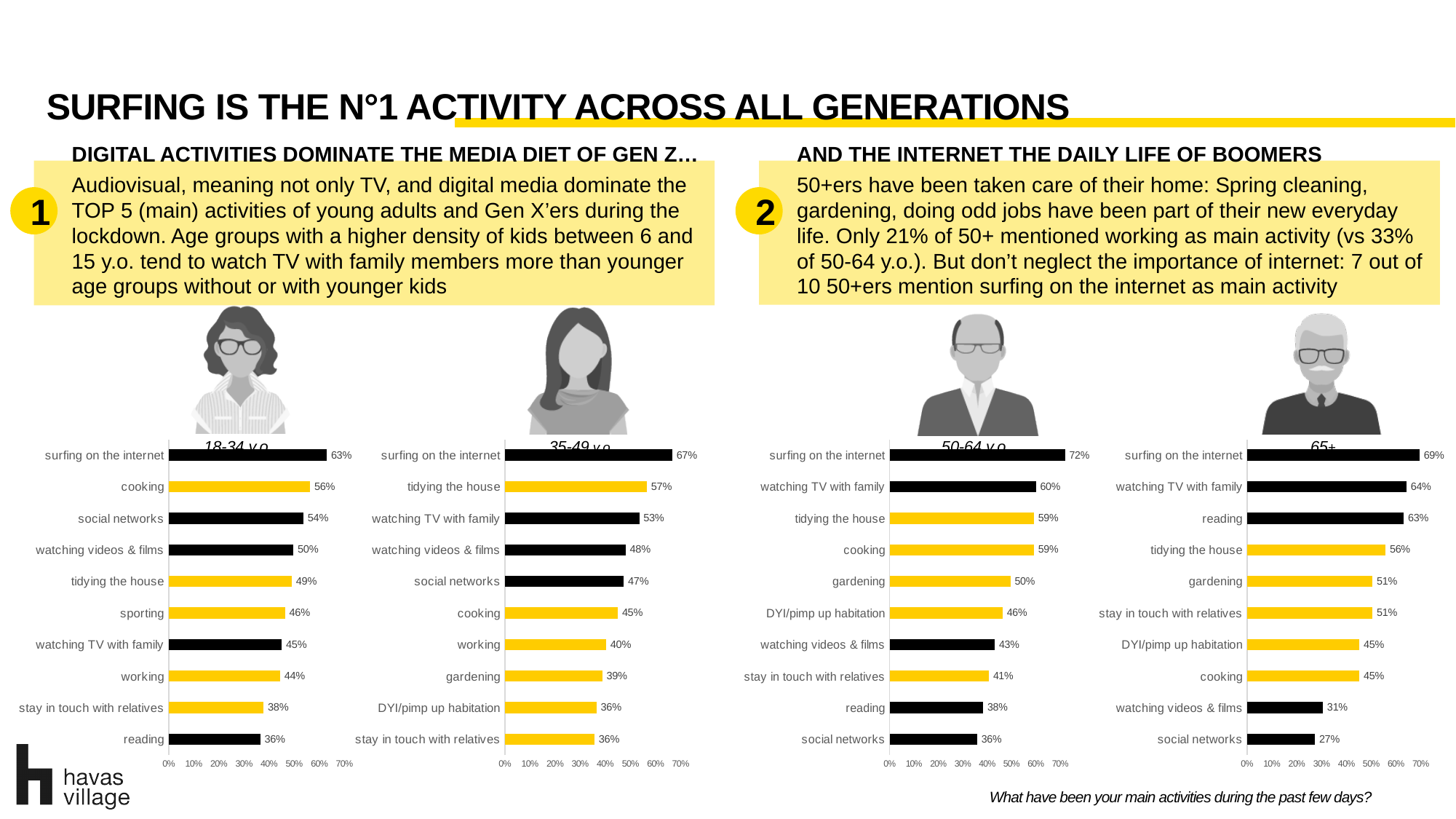
In the 65+ chart, what is the value for reading? 63% In the 50-64 y.o. chart, which activity has the highest value? surfing on the internet What type of chart is the 18-34 y.o. chart? bar chart In the 35-49 y.o. chart, what is the value for tidying the house? 57% How many charts are shown on the slide? 4 How many activities are listed in the 65+ chart? 10 In the 50-64 y.o. chart, what is the difference between watching TV with family and social networks? 24% In the 35-49 y.o. chart, which is larger: watching TV with family or cooking? watching TV with family In the 18-34 y.o. chart, what is the value for cooking? 56% In the 18-34 y.o. chart, what is the difference between surfing on the internet and reading? 27% In the 50-64 y.o. chart, what is the value for gardening? 50% In the 65+ chart, which activity has the lowest value? social networks